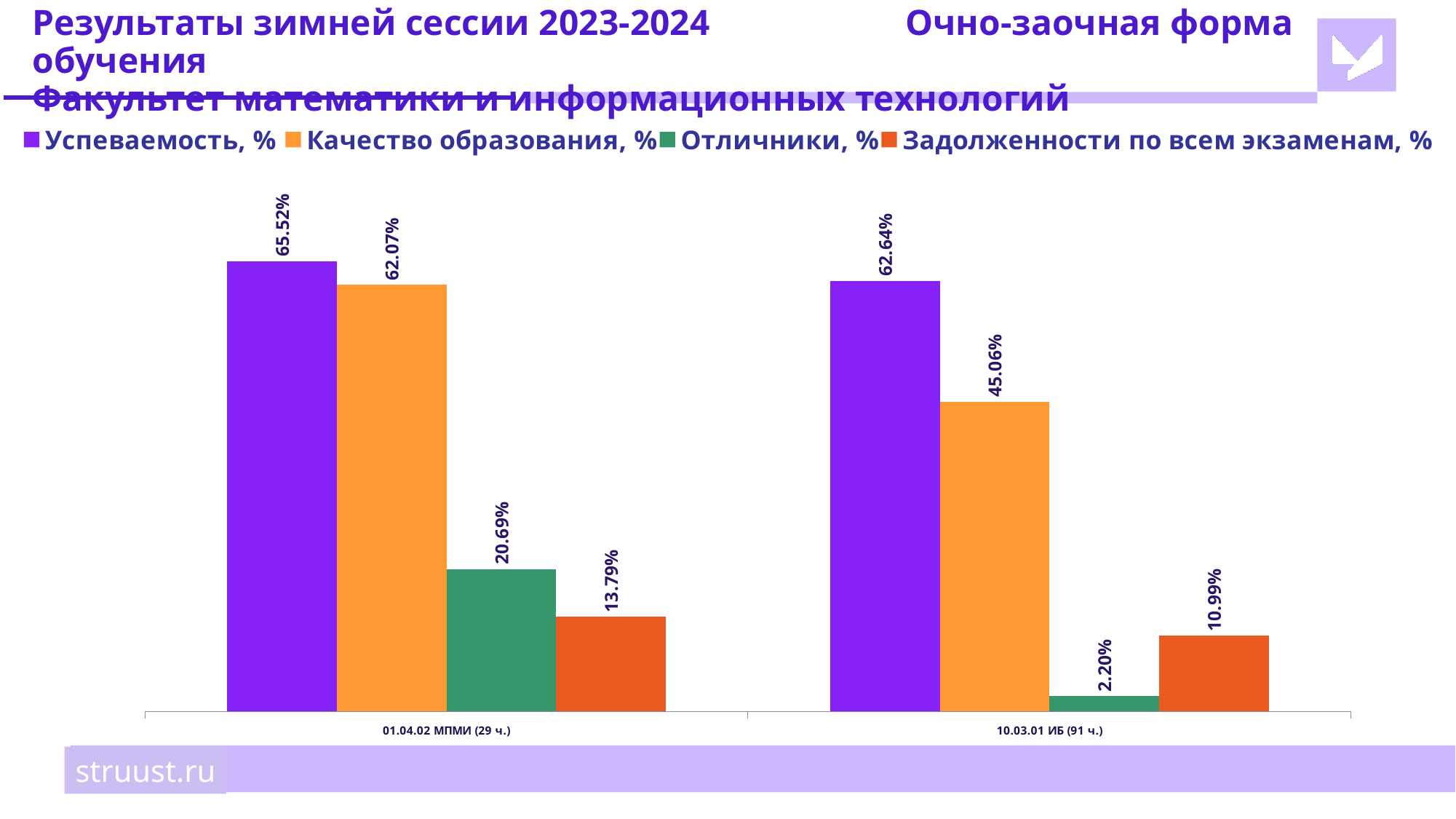
Which is larger: Задолженности по всем экзаменам, % for 01.04.02 МПМИ (29 ч.) or for 10.03.01 ИБ (91 ч.)? 01.04.02 МПМИ (29 ч.) What is the difference between Качество образования, % for 01.04.02 МПМИ (29 ч.) and for 10.03.01 ИБ (91 ч.)? 17.01% Which colour represents Отличники, % in the legend? Green How many categories are shown on the x axis? 2 What is the value of Задолженности по всем экзаменам, % for 01.04.02 МПМИ (29 ч.)? 13.79% What kind of chart is shown on the slide? Bar chart How many series does the legend list? 4 What is the value of Отличники, % for 10.03.01 ИБ (91 ч.)? 2.20% What is the value of Качество образования, % for 10.03.01 ИБ (91 ч.)? 45.06% Which category has the higher value for Отличники, %? 01.04.02 МПМИ (29 ч.) What is the value of Успеваемость, % for 01.04.02 МПМИ (29 ч.)? 65.52% Which series has the lowest value for 10.03.01 ИБ (91 ч.)? Отличники, %